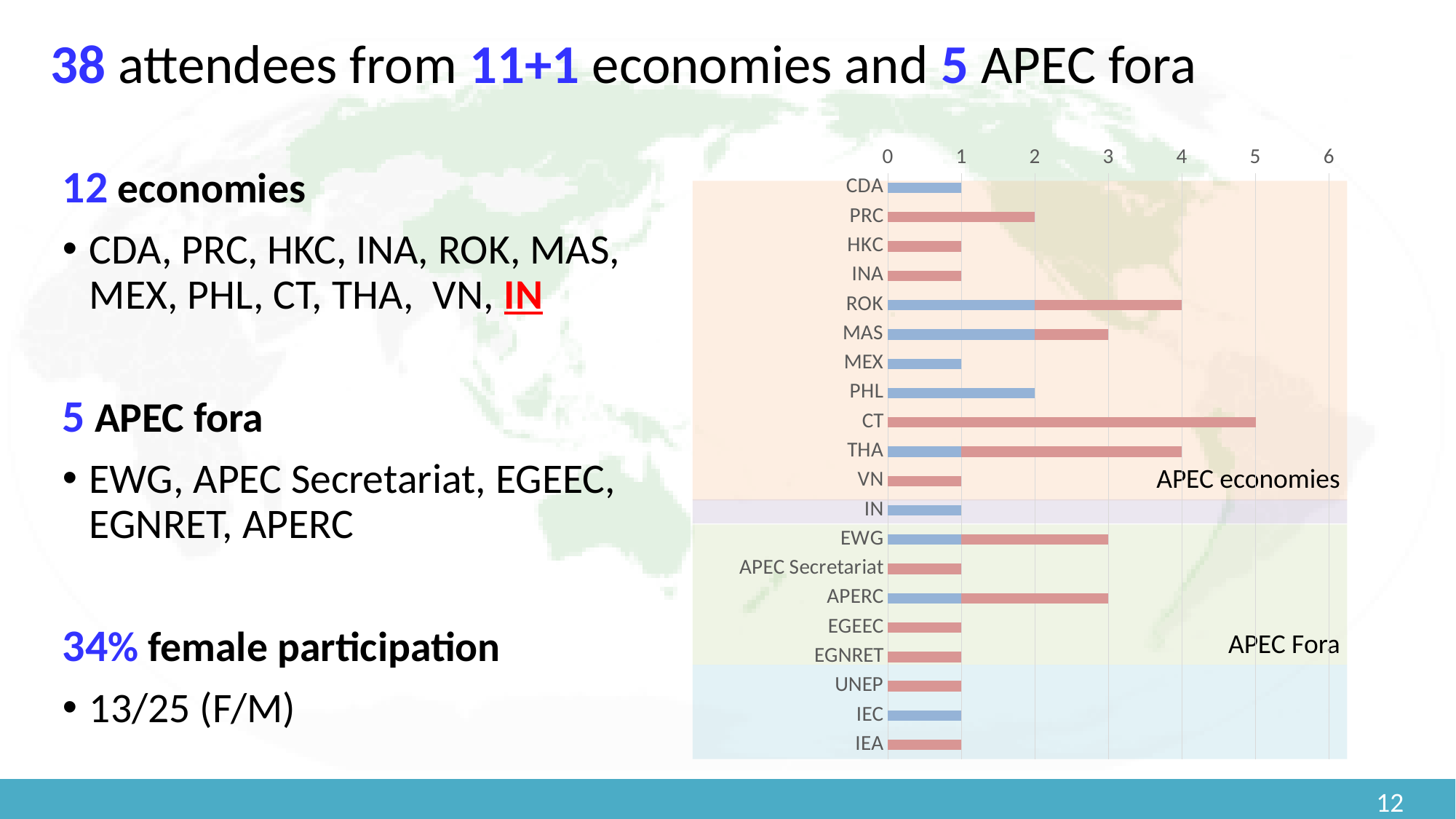
What is the value for PRC? 2 What are the two group labels printed inside the chart area? APEC economies and APEC Fora Is the total bar for EWG greater or less than 2? greater Is the bar for UNEP greater or less than 2? less Which is larger, the total bar for CT or the total bar for THA? CT What is the total bar length for MAS? 3 What is the difference between the total bar for CT and the bar for PRC? 3 What kind of chart is shown on the slide? bar chart What is the total bar length for ROK? 4 How many categories are listed on the chart's vertical axis? 20 Which category has the longest bar in the chart? CT What is the total bar length for CT? 5